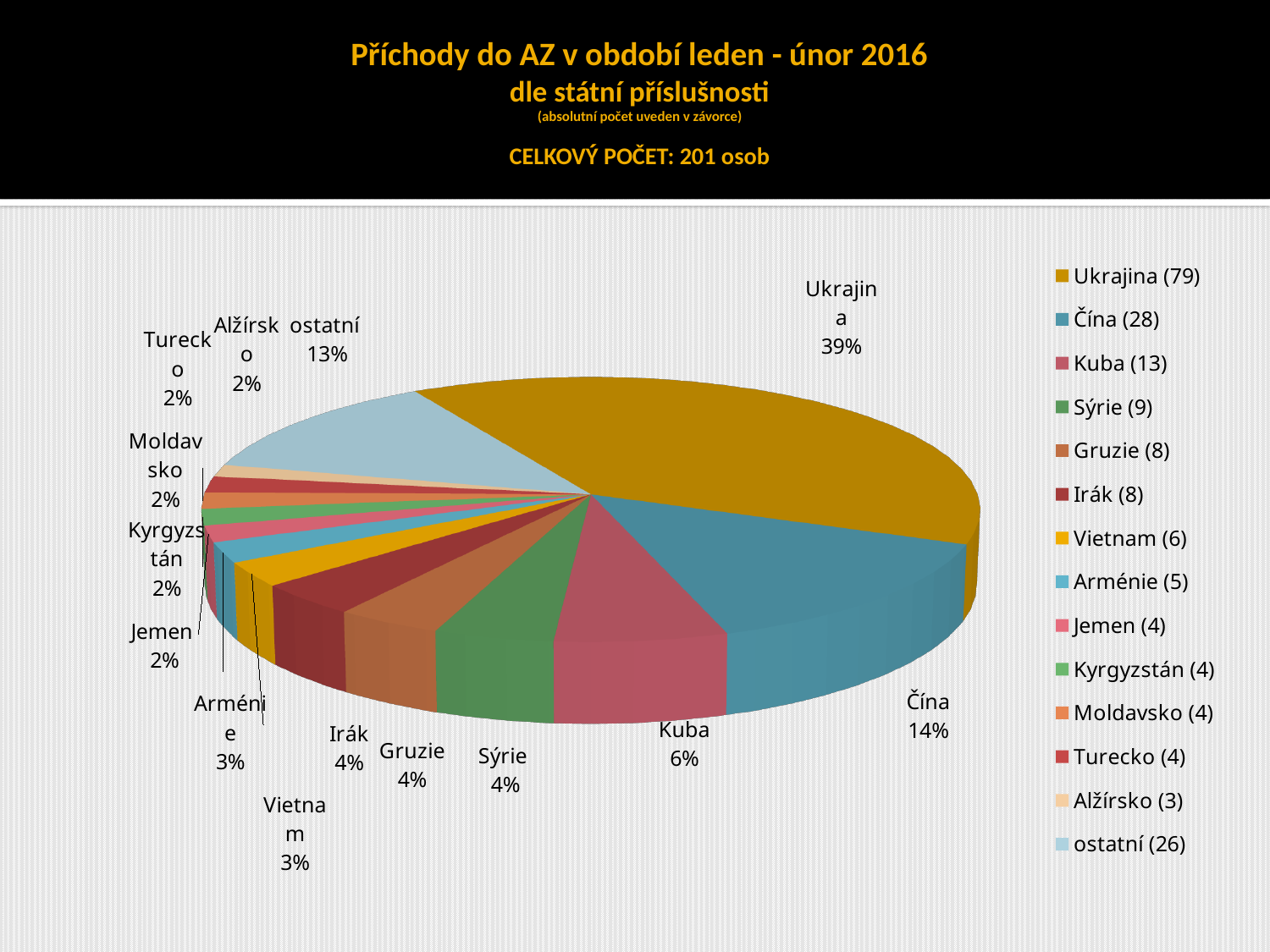
According to the legend, how many people came from Vietnam? 6 According to the legend, how many people came from Kuba? 13 How many slices does the pie chart have? 14 Which country has the largest slice of the pie chart? Ukrajina What percentage share is labelled for the 'ostatní' slice? 13% What percentage share does Ukrajina have in the pie chart? 39% What is the total number of people (CELKOVÝ POČET) stated on the slide? 201 osob Which slice is larger, Kuba or Sýrie? Kuba What type of chart is shown on the slide? Pie chart What is the difference in percentage points between the Ukrajina slice and the Čína slice? 25 What percentage share does Čína have in the pie chart? 14% Which named country has the smallest absolute count in the legend? Alžírsko